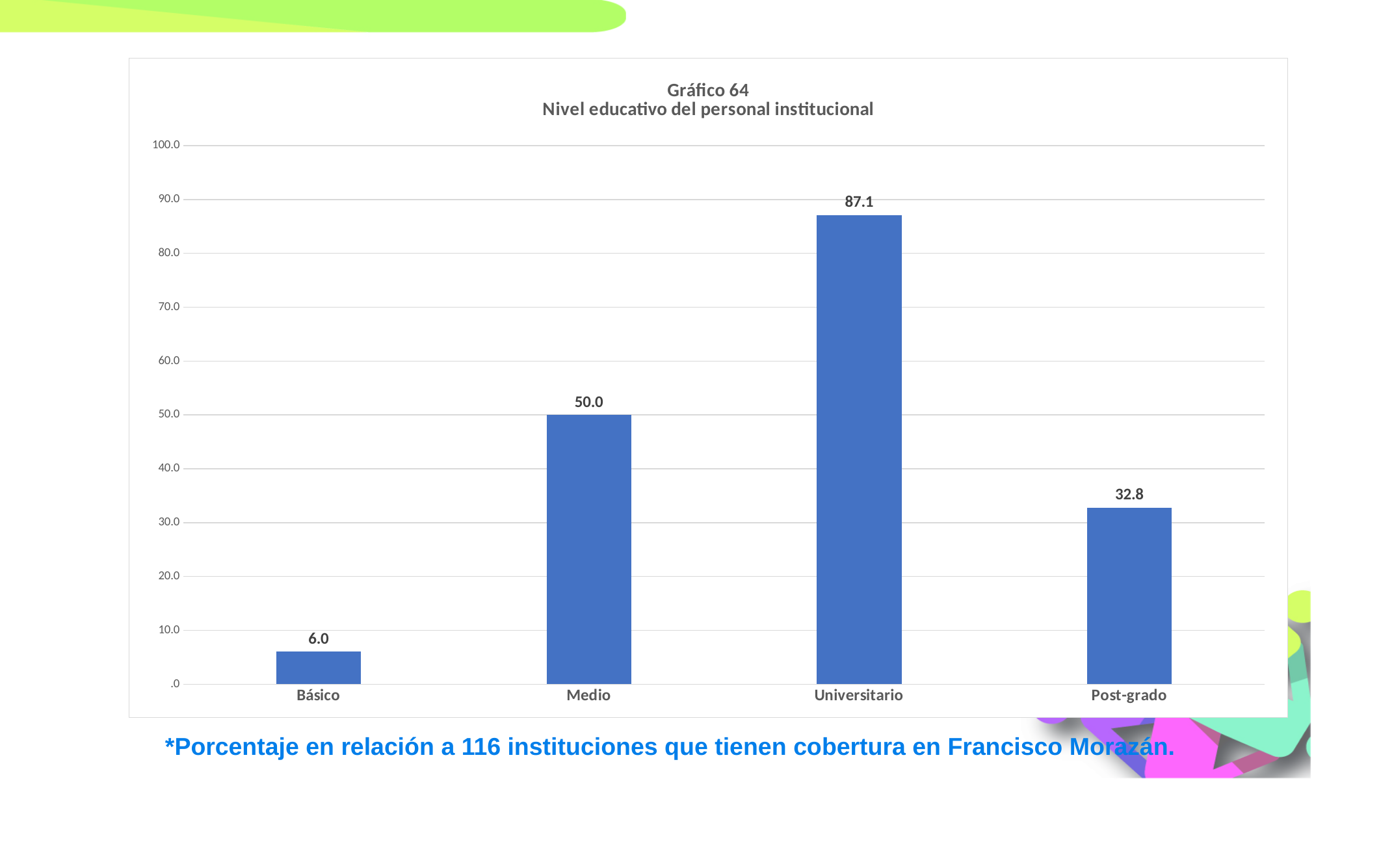
What is the value for Medio? 50.0 What kind of chart is shown? Bar chart What is the difference between the values for Post-grado and Básico? 26.8 What is the value for Universitario? 87.1 How many categories are shown on the x axis? 4 What is the title of the chart? Gráfico 64 Nivel educativo del personal institucional What is the value for Post-grado? 32.8 What is the value for Básico? 6.0 What is the difference between the values for Universitario and Medio? 37.1 Which is larger, the value for Medio or the value for Post-grado? Medio Which category has the highest value? Universitario Which category has the lowest value? Básico